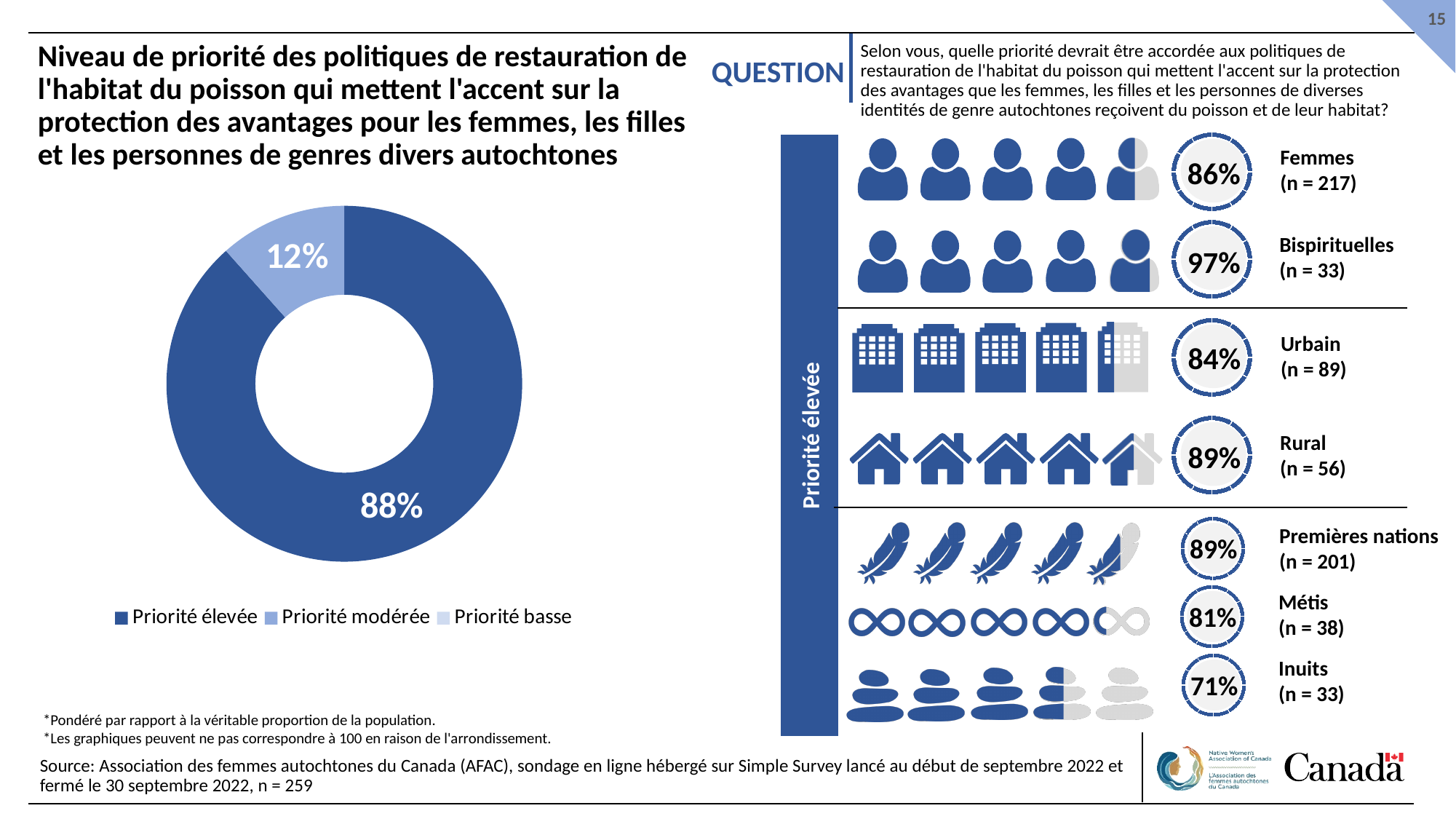
In the Priorité élevée infographic on the right, which group has the highest percentage? Bispirituelles What kind of chart is shown on the left of the slide? Donut (pie) chart How many categories does the legend of the donut chart on the left list? 3 In the donut chart on the left, which category has the largest share? Priorité élevée In the Priorité élevée infographic on the right, which is higher: Urbain or Rural? Rural In the donut chart on the left, what percentage is shown for Priorité élevée? 88% In the donut chart on the left, what percentage is shown for Priorité modérée? 12% In the Priorité élevée infographic on the right, what percentage is shown for Inuits? 71% In the donut chart on the left, what is the difference in percentage points between Priorité élevée and Priorité modérée? 76 percentage points In the Priorité élevée infographic on the right, what is the difference in percentage points between Femmes and Bispirituelles? 11 percentage points In the Priorité élevée infographic on the right, what percentage is shown for Bispirituelles? 97% In the Priorité élevée infographic on the right, which group has the lowest percentage? Inuits